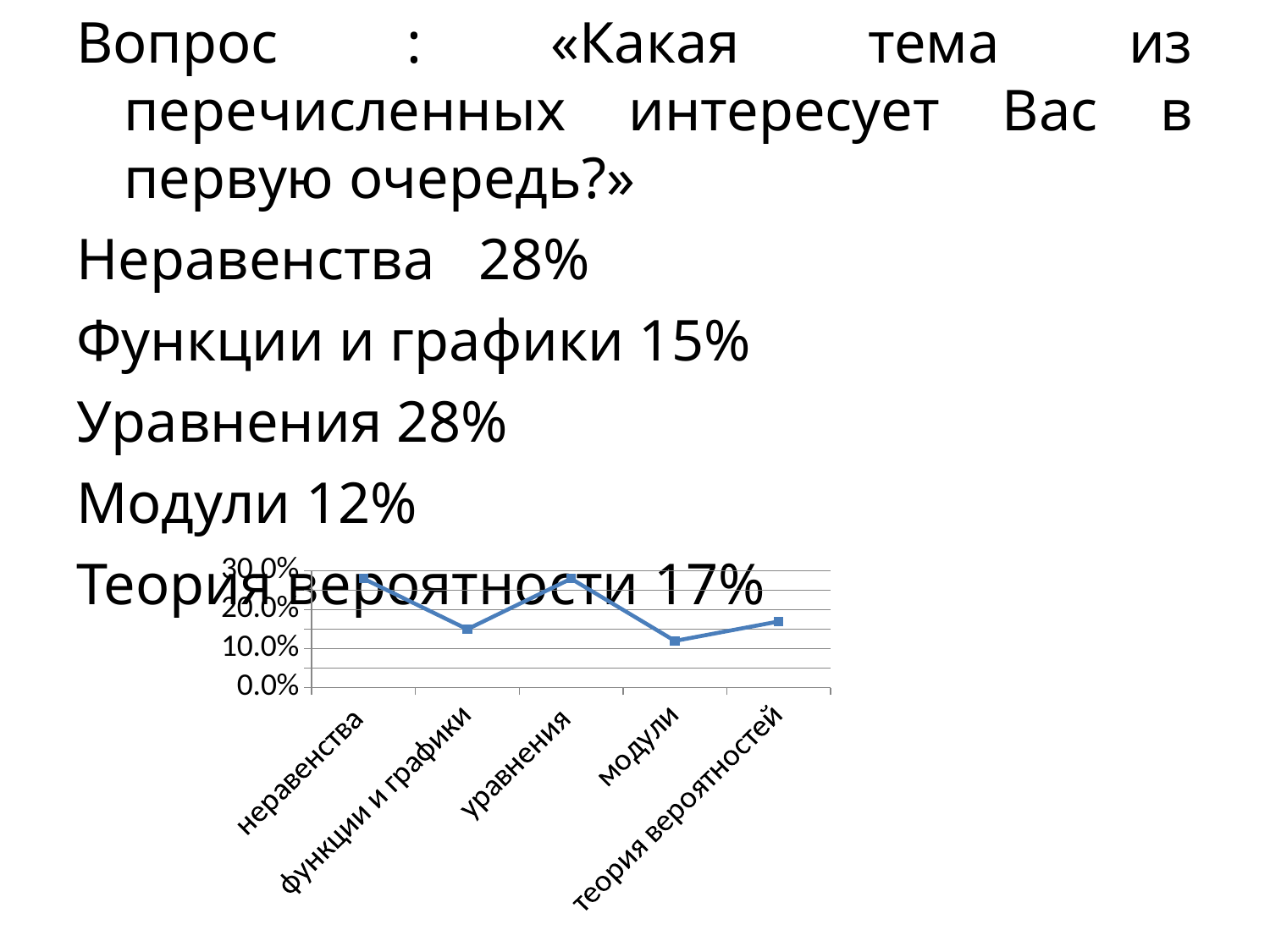
Is the value for теория вероятностей greater or less than 20.0%? less Is the value for уравнения greater or less than 20.0%? greater Is the value for неравенства greater or less than 20.0%? greater What is the highest tick value shown on the vertical axis of the chart? 30.0% How many categories are plotted on the x axis of the chart? 5 Which category has the lowest value in the chart? модули What kind of chart is shown on the slide? line chart Which is larger, the value for неравенства or the value for функции и графики? неравенства Which is larger, the value for уравнения or the value for модули? уравнения Does the line rise or fall from уравнения to модули? fall